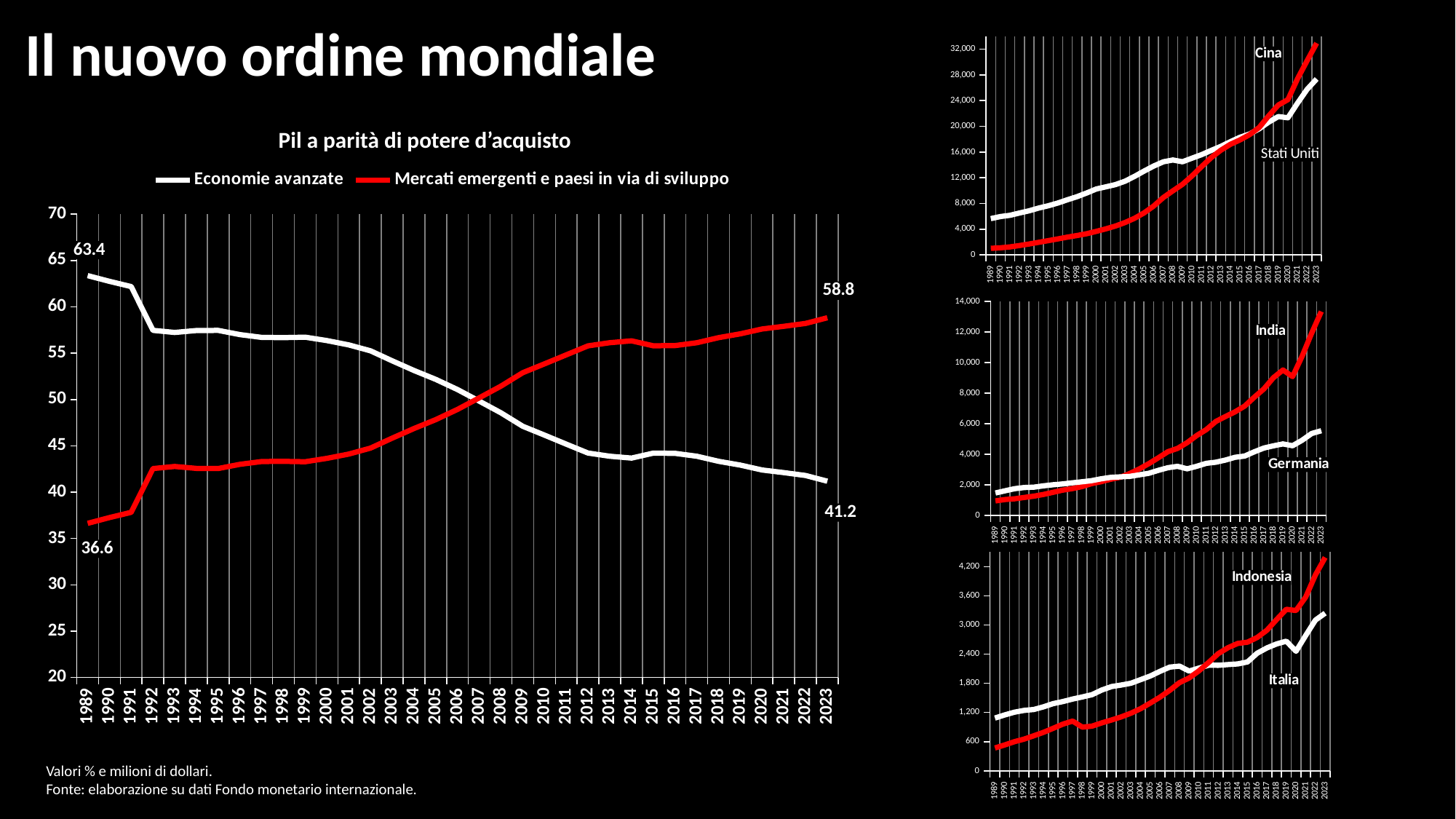
In the chart 'Pil a parità di potere d'acquisto', what is the value for Mercati emergenti e paesi in via di sviluppo in 2023? 58.8 In the chart 'Pil a parità di potere d'acquisto', what is the difference between the 1989 values of Economie avanzate and Mercati emergenti e paesi in via di sviluppo? 26.8 In the chart 'Pil a parità di potere d'acquisto', which series has the larger value in 2023? Mercati emergenti e paesi in via di sviluppo In the chart 'Pil a parità di potere d'acquisto', is the value for Economie avanzate in 2010 greater or less than 50? less In the top-right chart (Cina / Stati Uniti), is the value for Cina in 2023 greater or less than 28,000? greater What kind of chart is 'Pil a parità di potere d'acquisto'? line chart In the chart 'Pil a parità di potere d'acquisto', what is the value for Economie avanzate in 2023? 41.2 In the chart 'Pil a parità di potere d'acquisto', what is the value for Economie avanzate in 1989? 63.4 In the bottom-right chart (Indonesia / Italia), is the value for Indonesia in 1989 greater or less than 600? less In the middle-right chart (India / Germania), which series has the larger value in 2023? India In the chart 'Pil a parità di potere d'acquisto', does the Economie avanzate series rise or fall from 1989 to 2023? fall How many series does the legend of the chart 'Pil a parità di potere d'acquisto' list? 2